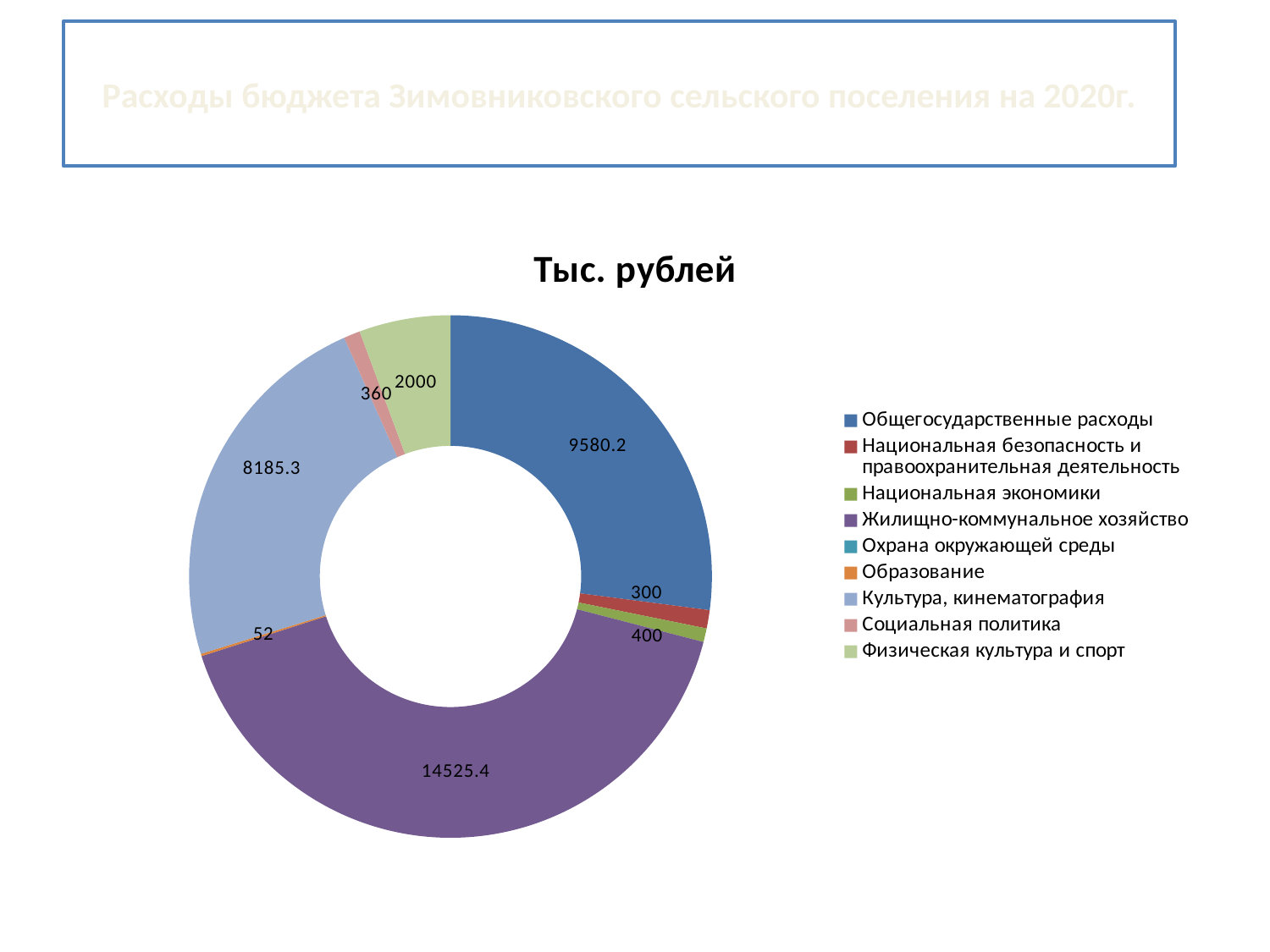
How many categories does the legend list? 9 What is the value for Физическая культура и спорт? 2000 What is the value for Жилищно-коммунальное хозяйство? 14525.4 Which is larger, Национальная экономики or Национальная безопасность и правоохранительная деятельность? Национальная безопасность и правоохранительная деятельность What is the title of the chart? Тыс. рублей Which category has the largest value? Жилищно-коммунальное хозяйство What is the value for Социальная политика? 360 What kind of chart is shown on the slide? Doughnut (pie) chart What is the difference between Жилищно-коммунальное хозяйство and Общегосударственные расходы? 4945.2 What is the value for Культура, кинематография? 8185.3 What is the value for Общегосударственные расходы? 9580.2 What is the value for Образование? 52